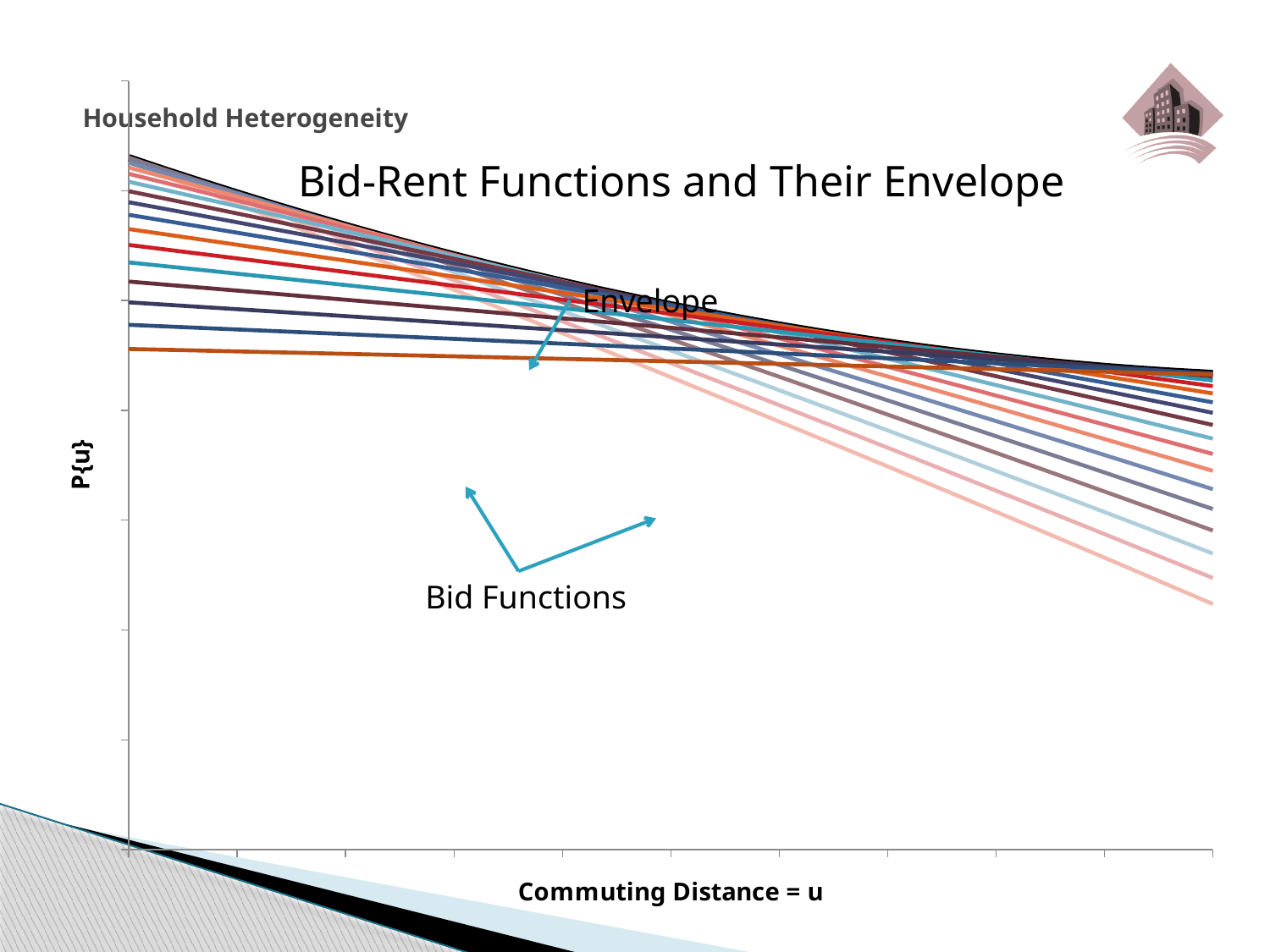
Do the bid functions rise or fall as commuting distance u increases? fall What kind of chart is shown on the slide? line chart Are the individual bid functions drawn as straight lines or curves? straight lines What is the label on the x axis of the chart? Commuting Distance = u Does the envelope become steeper or flatter as commuting distance increases? flatter What is the title of the chart? Bid-Rent Functions and Their Envelope